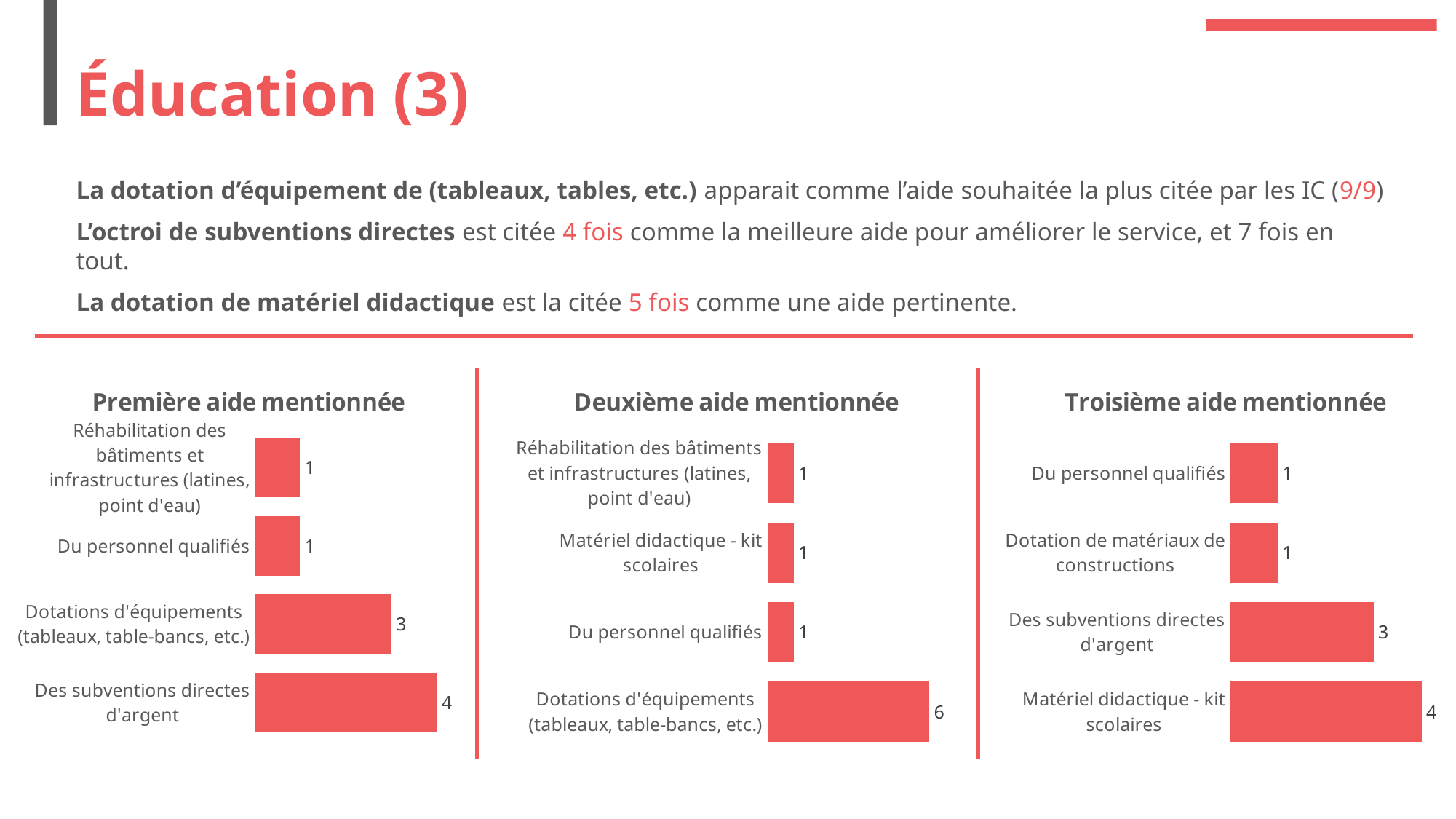
In the 'Deuxième aide mentionnée' chart, what is the value for 'Dotations d'équipements (tableaux, table-bancs, etc.)'? 6 In the 'Première aide mentionnée' chart, how many categories are shown? 4 In the 'Deuxième aide mentionnée' chart, what is the value for 'Matériel didactique - kit scolaires'? 1 How many charts are shown on the slide? 3 In the 'Première aide mentionnée' chart, what is the difference between 'Des subventions directes d'argent' and 'Dotations d'équipements (tableaux, table-bancs, etc.)'? 1 What type of chart is the 'Deuxième aide mentionnée' chart? Bar chart In the 'Première aide mentionnée' chart, what is the value for 'Des subventions directes d'argent'? 4 In the 'Première aide mentionnée' chart, which category has the highest value? Des subventions directes d'argent In the 'Troisième aide mentionnée' chart, what is the value for 'Des subventions directes d'argent'? 3 In the 'Troisième aide mentionnée' chart, which is larger: 'Des subventions directes d'argent' or 'Du personnel qualifiés'? Des subventions directes d'argent In the 'Troisième aide mentionnée' chart, which category has the highest value? Matériel didactique - kit scolaires In the 'Deuxième aide mentionnée' chart, what is the difference between 'Dotations d'équipements (tableaux, table-bancs, etc.)' and 'Du personnel qualifiés'? 5